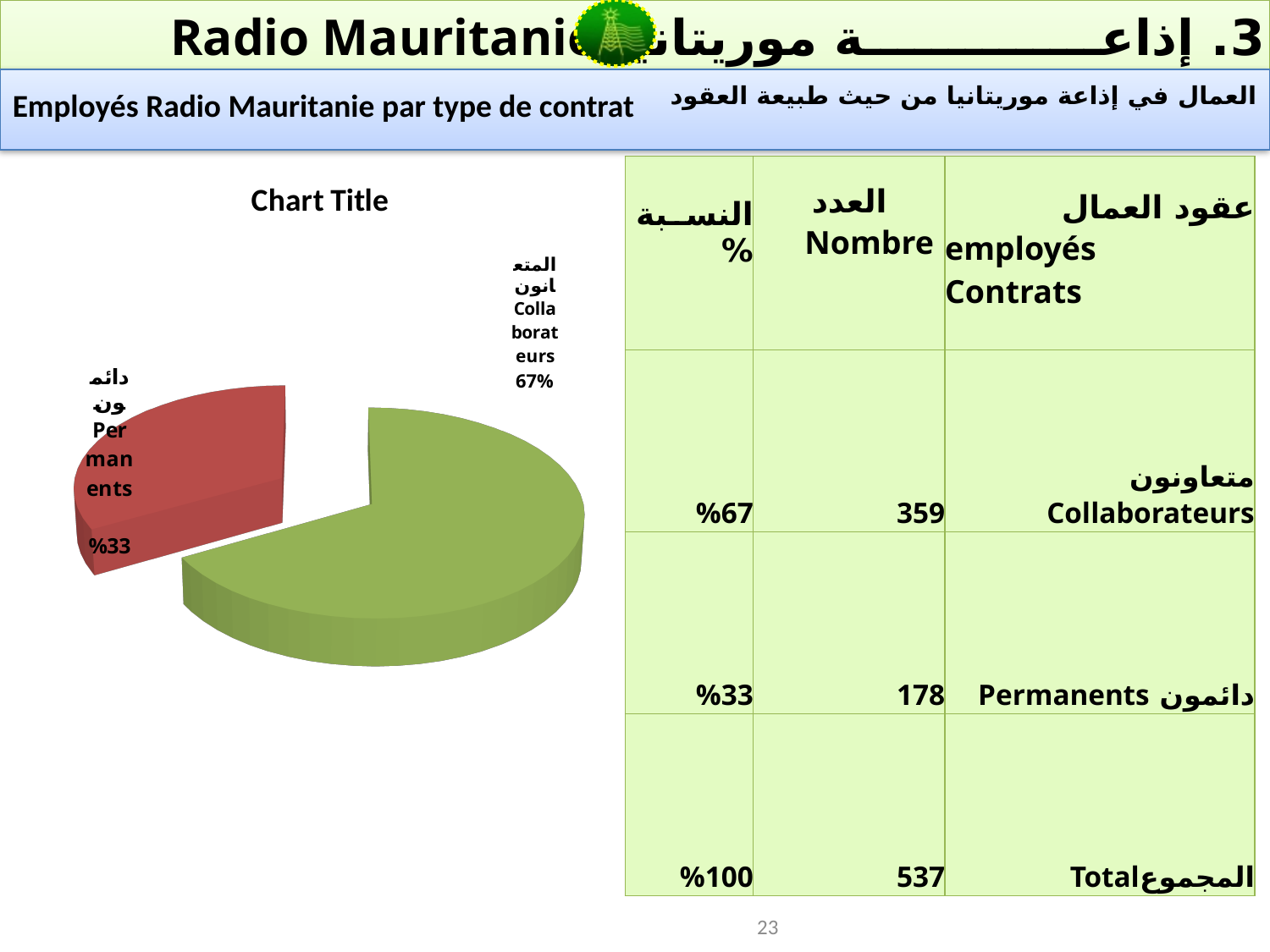
Which slice is larger in the pie chart, Collaborateurs or Permanents? Collaborateurs How many slices does the pie chart have? 2 Which category has the smallest slice in the pie chart? Permanents What share of the pie chart does the Collaborateurs slice represent? 67% What is the title shown above the pie chart? Chart Title By how many percentage points does the Collaborateurs share exceed the Permanents share in the pie chart? 34 percentage points What share of the pie chart does the Permanents slice represent? 33% Which category has the largest slice in the pie chart? Collaborateurs What colour is the Permanents slice in the pie chart? Red What type of chart is shown on the slide? Pie chart